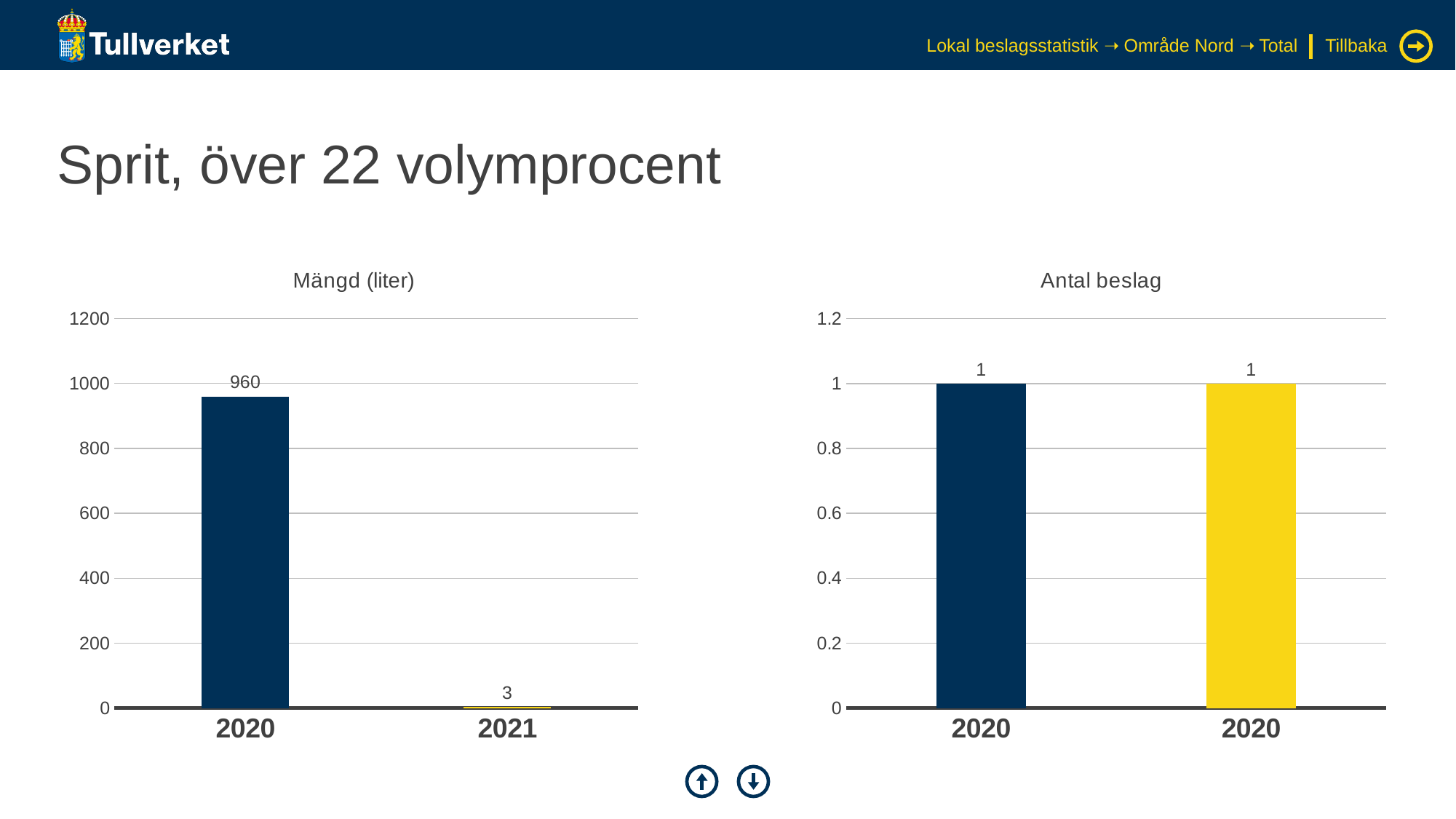
What kind of chart is the "Antal beslag" chart? bar chart In the "Mängd (liter)" chart, which year has the lowest value? 2021 In the "Mängd (liter)" chart, do the values rise or fall from 2020 to 2021? fall In the "Mängd (liter)" chart, what is the difference between the 2020 and 2021 values? 957 How many bars are shown in the "Mängd (liter)" chart? 2 In the "Antal beslag" chart, what is the value of the dark blue bar on the left? 1 What is the title of the chart on the right side of the slide? Antal beslag In the "Mängd (liter)" chart, what is the value for 2020? 960 In the "Antal beslag" chart, what is the value of the yellow bar on the right? 1 In the "Mängd (liter)" chart, what is the value for 2021? 3 In the "Mängd (liter)" chart, is the value for 2020 greater or less than 800? greater In the "Mängd (liter)" chart, which year has the highest value? 2020